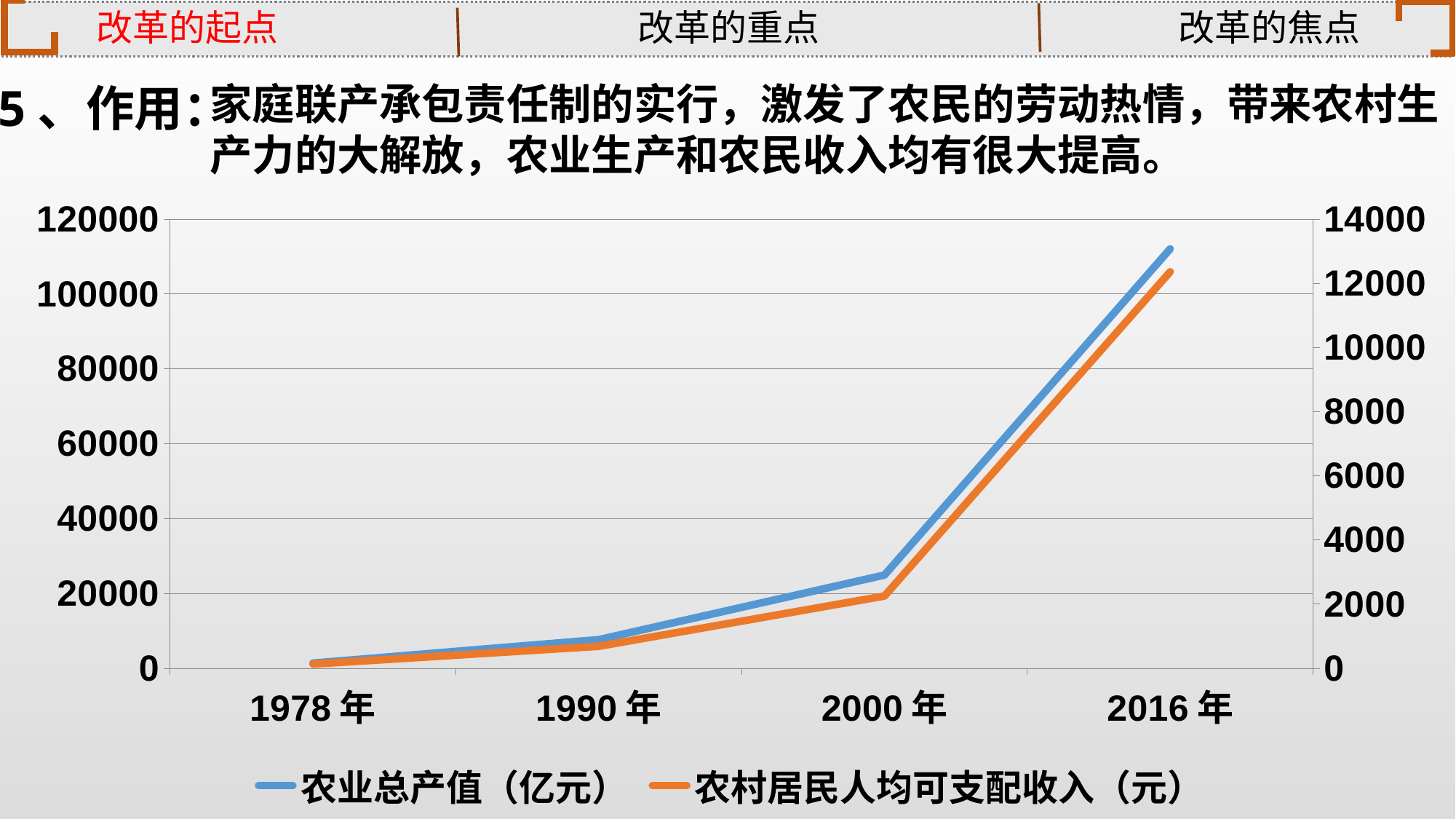
Is the value for 农村居民人均可支配收入（元） in 2016年 greater or less than 10000 on the right axis? greater Which series is drawn in blue? 农业总产值（亿元） How many series does the legend list? 2 In which year is 农村居民人均可支配收入（元） lowest? 1978年 Is the value for 农业总产值（亿元） in 2016年 greater or less than 100000 on the left axis? greater Which series is drawn in orange? 农村居民人均可支配收入（元） How many years are plotted along the x axis? 4 What kind of chart is shown on the slide? line chart Do the values for 农业总产值（亿元） rise or fall from 1978年 to 2016年? rise Do the values for 农村居民人均可支配收入（元） rise or fall from 1978年 to 2016年? rise In which year is 农业总产值（亿元） highest? 2016年 Is the value for 农业总产值（亿元） in 1990年 greater or less than 20000 on the left axis? less